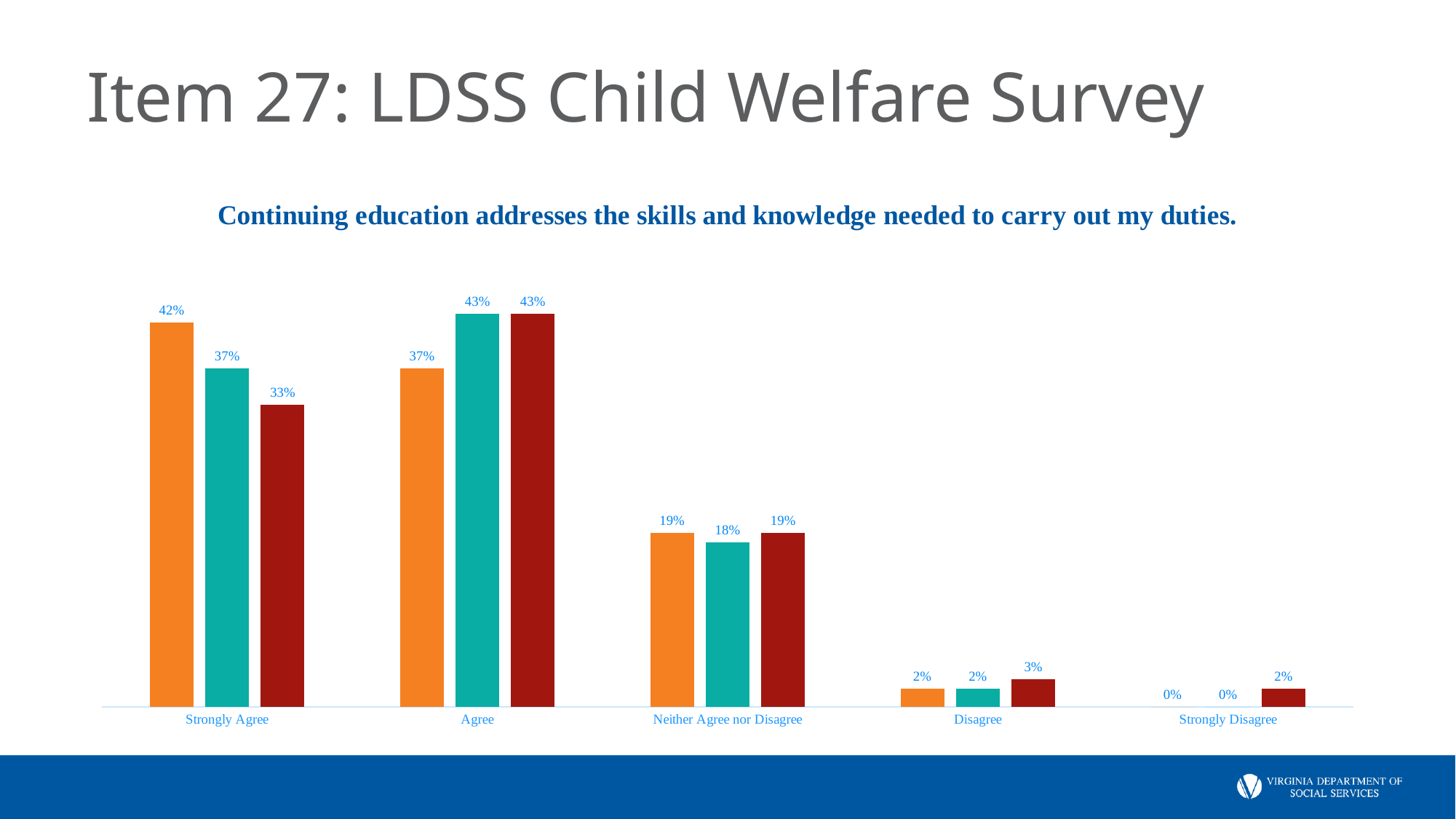
What is the value of the teal bar for Agree? 43% What is the value of the teal bar for Neither Agree nor Disagree? 18% How many categories are shown on the x axis? 5 Which category has the lowest value for the dark red bars? Strongly Disagree For Strongly Agree, which is larger: the orange bar or the teal bar? The orange bar What type of chart is shown on the slide? Bar chart What is the value of the dark red bar for Strongly Agree? 33% What is the value of the orange bar for Strongly Agree? 42% What is the value of the dark red bar for Disagree? 3% Which category has the highest value for the orange bars? Strongly Agree What is the difference between the orange bar and the dark red bar for Strongly Agree? 9% What is the value of the orange bar for Strongly Disagree? 0%